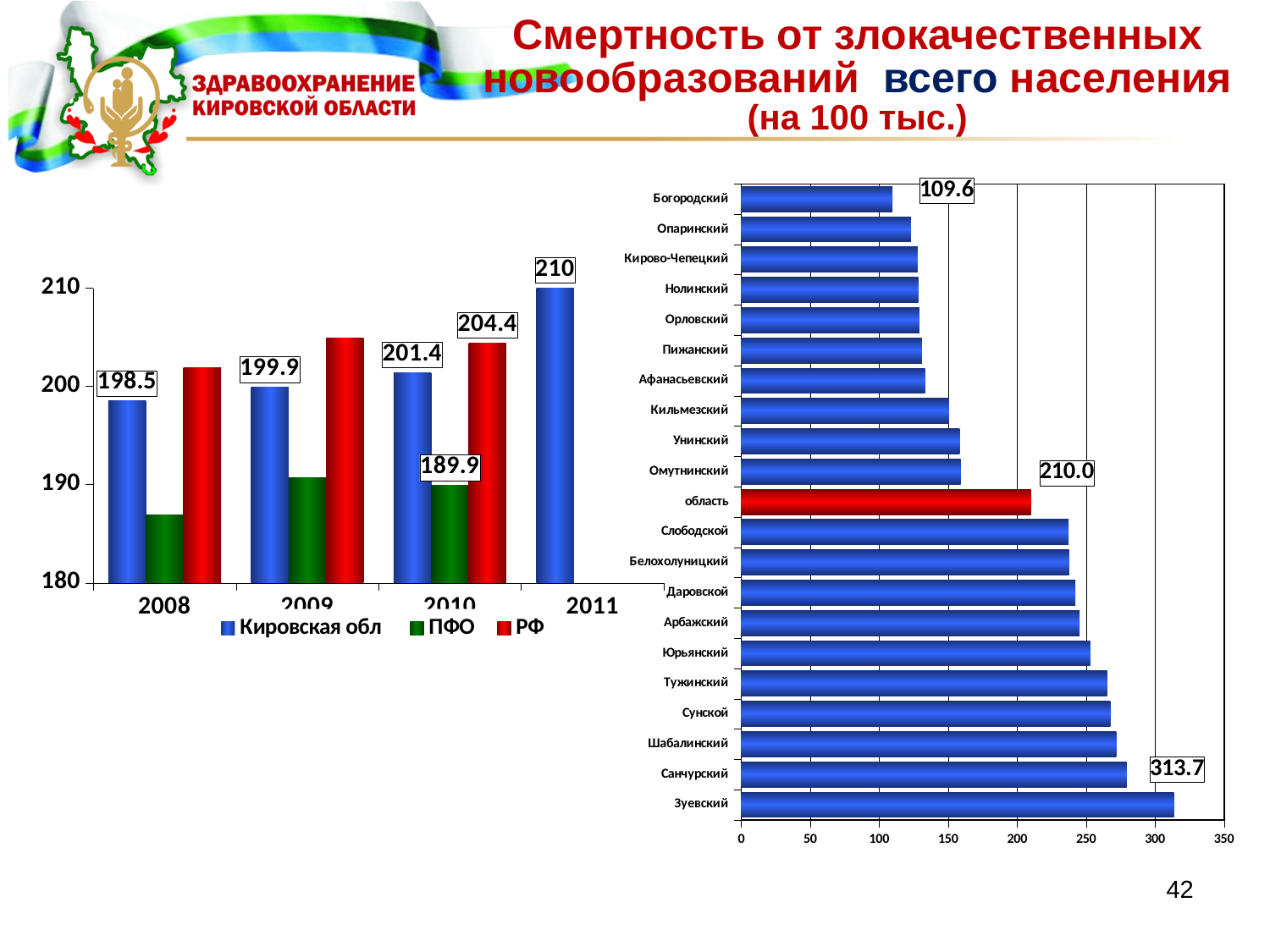
On the left chart, what is the difference between the Кировская обл values for 2011 and 2008? 11.5 On the left chart, how many series does the legend list? 3 On the right chart, is the value for Слободской greater or less than 200? greater On the left chart, what is the value for Кировская обл in 2011? 210 On the left chart, what is the value for РФ in 2010? 204.4 On the left chart, what is the value for ПФО in 2010? 189.9 On the right chart, what is the value for область? 210.0 On the right chart, which district has the highest value? Зуевский On the right chart, which district has the lowest value? Богородский On the left chart, which is larger in 2010: РФ or Кировская обл? РФ On the left chart, do the values for Кировская обл rise or fall from 2008 to 2011? rise What kind of chart is the right chart? bar chart